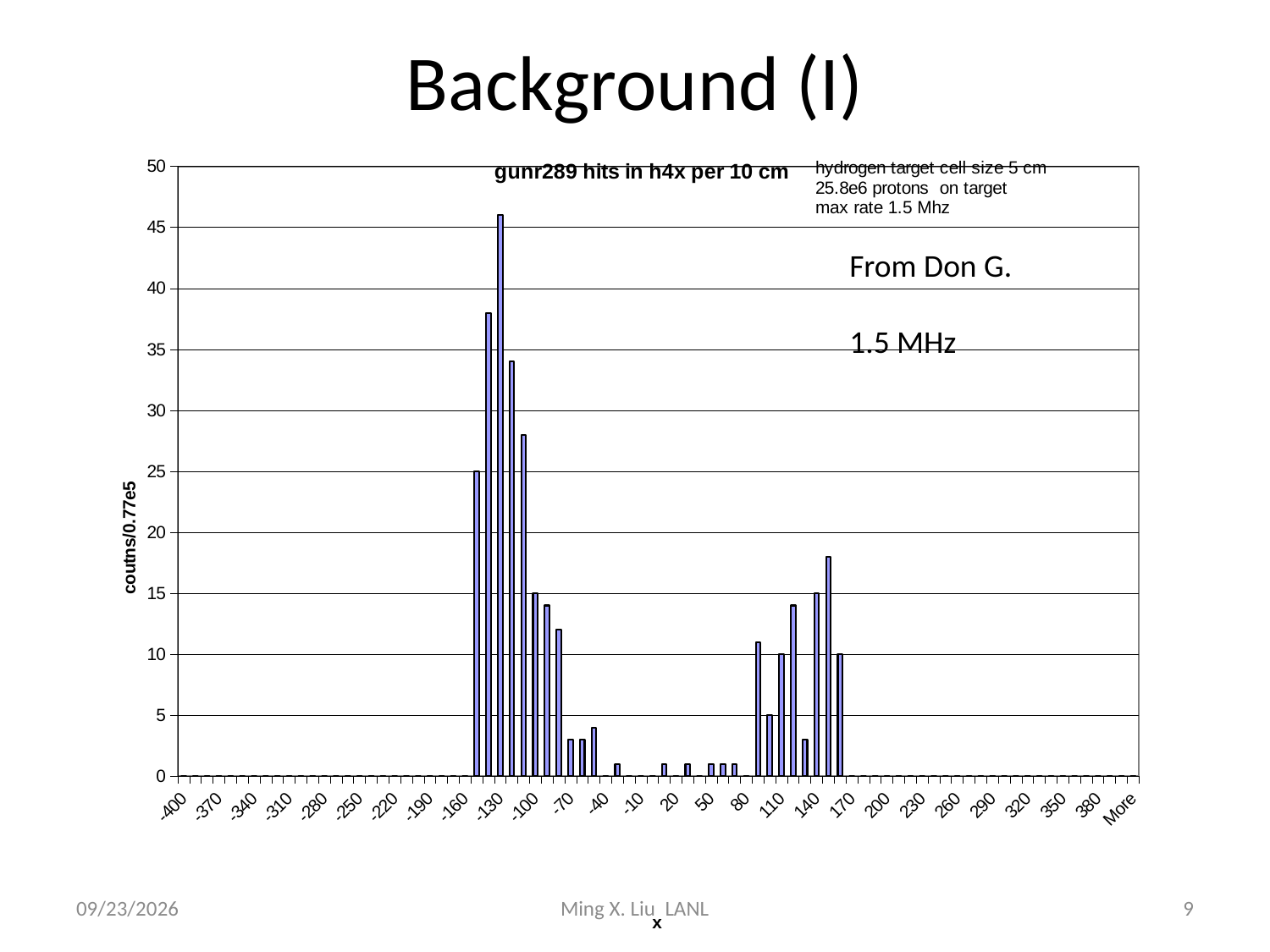
Are there any bars with values above 0 between x = -400 and x = -190? no Which cluster of bars reaches higher values: the one near x = -130 or the one near x = 140? the one near x = -130 What is the title of the chart? gunr289 hits in h4x per 10 cm Is the tallest bar in the right-hand cluster (between x = 140 and x = 170) greater or less than 20? less Is the value of the tallest bar in the chart greater or less than 40? greater What is the label of the vertical axis of the chart? coutns/0.77e5 What is the maximum value shown on the vertical axis? 50 What kind of chart is shown on the slide? bar chart Between x = -130 and x = -70, do the bar heights rise or fall as x increases? fall